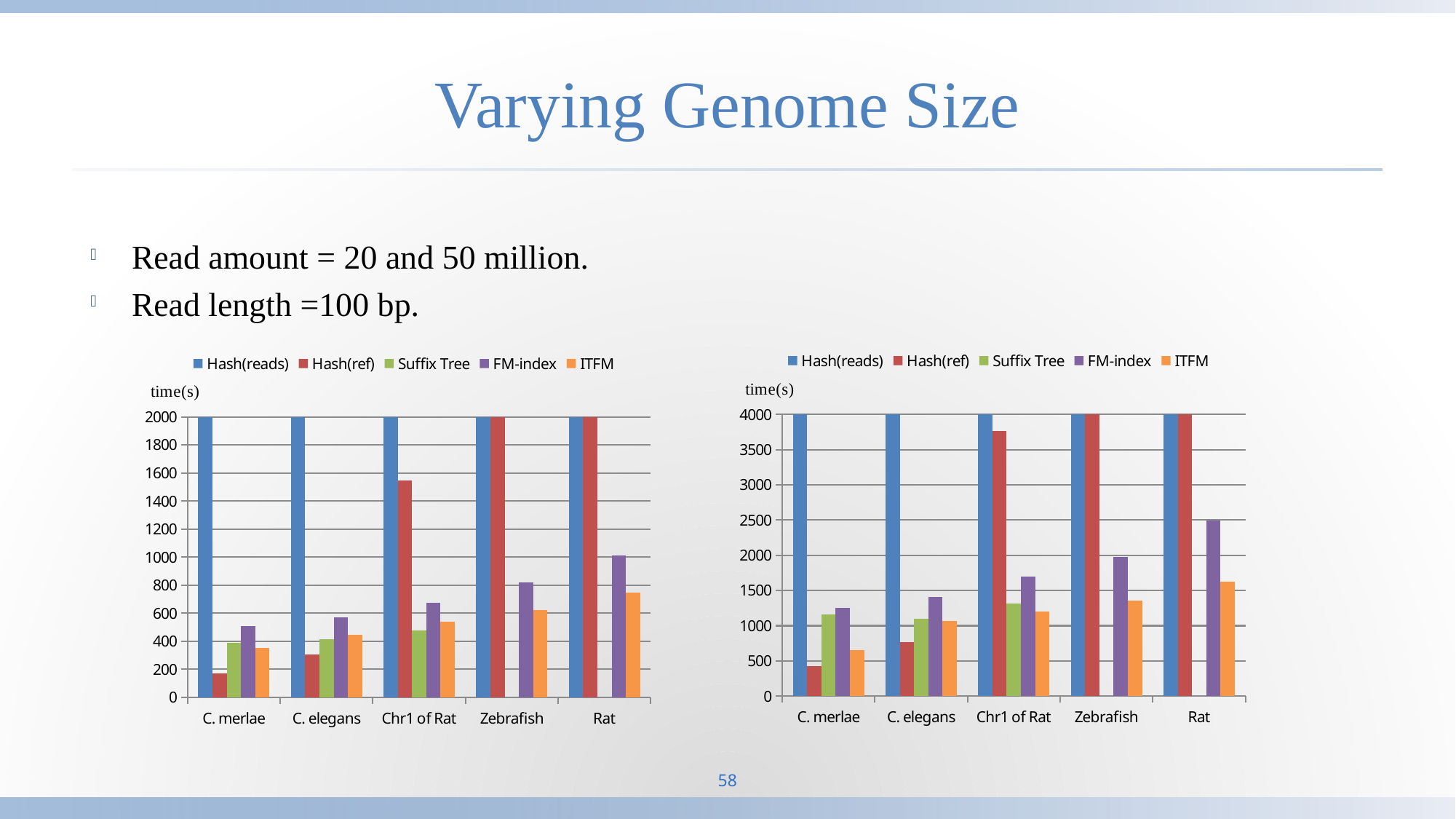
In the left chart, which is larger for Zebrafish: FM-index or ITFM? FM-index In the right chart, which category has the lowest Hash(ref) value? C. merlae In the left chart, is the Hash(ref) value for Chr1 of Rat greater or less than 1400? greater In the right chart, is the FM-index value for Rat greater or less than 2000? greater In the right chart, do the ITFM values rise or fall from C. merlae to Rat along the x axis? rise What kind of chart is the left chart on the slide? bar chart How many series does the legend of the right chart list? 5 How many categories are shown on the x axis of the left chart? 5 What is the label on the vertical axis of the right chart? time(s) In the left chart, is the ITFM value for Rat greater or less than 600? greater In the right chart, which is larger for C. elegans: Suffix Tree or FM-index? FM-index In the left chart, which category has the highest ITFM value? Rat